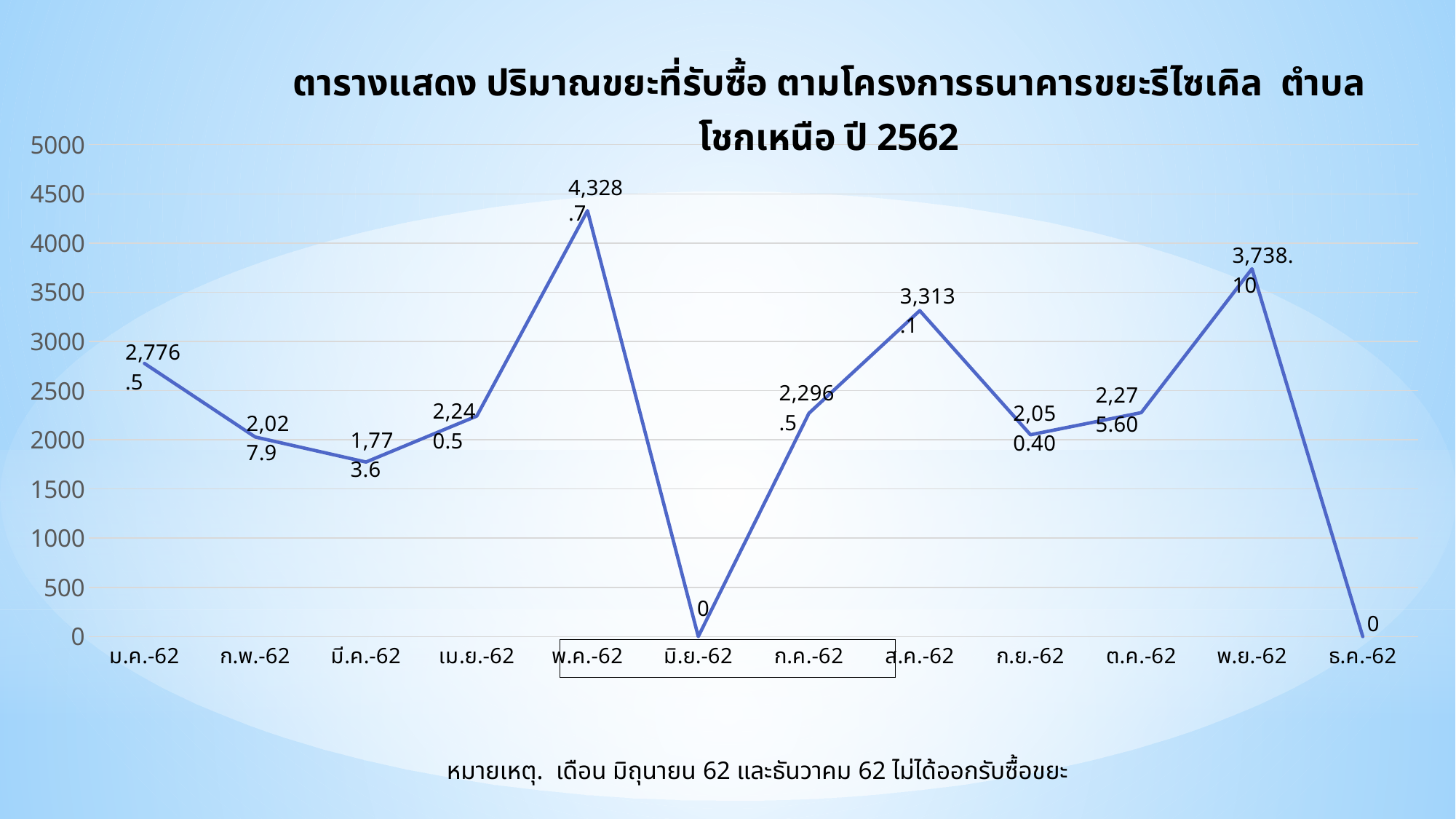
What is the value for พ.ค.-62? 4,328.7 How many months have a value of 0? 2 What kind of chart is shown? line chart What is the difference between the values for พ.ค.-62 and พ.ย.-62? 590.6 What is the value for ก.ย.-62? 2,050.40 Which is larger, the value for ส.ค.-62 or ก.ย.-62? ส.ค.-62 How many months are plotted on the x axis? 12 What is the value for ม.ค.-62? 2,776.5 What is the value for พ.ย.-62? 3,738.10 Which month has the highest value? พ.ค.-62 Is the value for ต.ค.-62 greater or less than 2000? greater What is the difference between the values for ม.ค.-62 and ก.พ.-62? 748.6